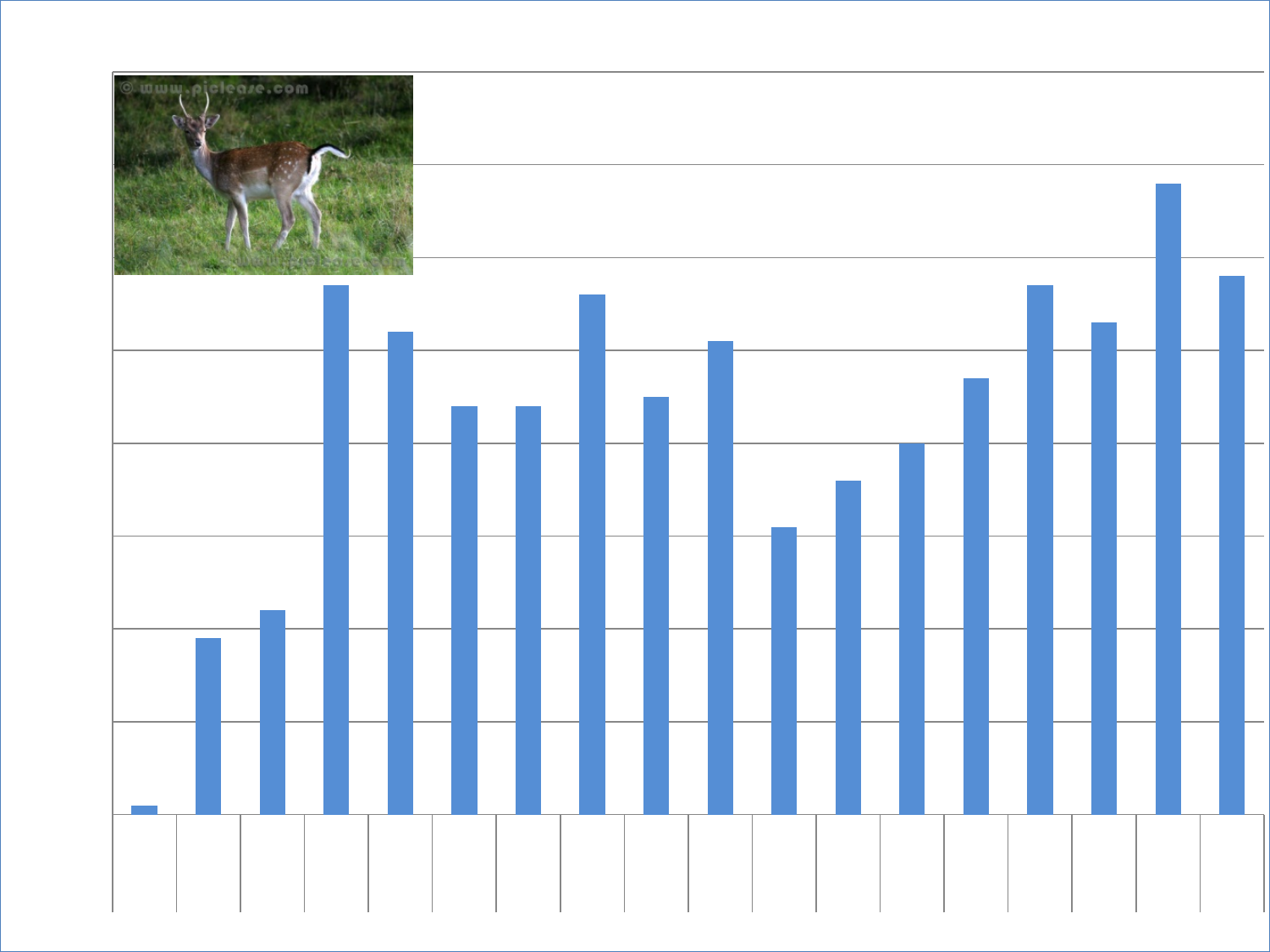
Which is taller, the fourth bar or the fifth bar from the left? the fourth bar What kind of chart is shown on the slide? bar chart Which bar is the shortest in the chart? the first (leftmost) bar Which is taller, the leftmost bar or the rightmost bar? the rightmost bar Which is taller, the 11th bar or the 12th bar from the left? the 12th bar What colour are the bars in the chart? blue Do the bar values rise or fall from the 11th bar to the 15th bar from the left? rise How many bars are plotted in the chart? 18 Do the bar values rise or fall from the first bar to the fourth bar from the left? rise What animal is shown in the picture placed over the chart? a deer Which bar is the tallest in the chart? the 17th bar (second from the right)